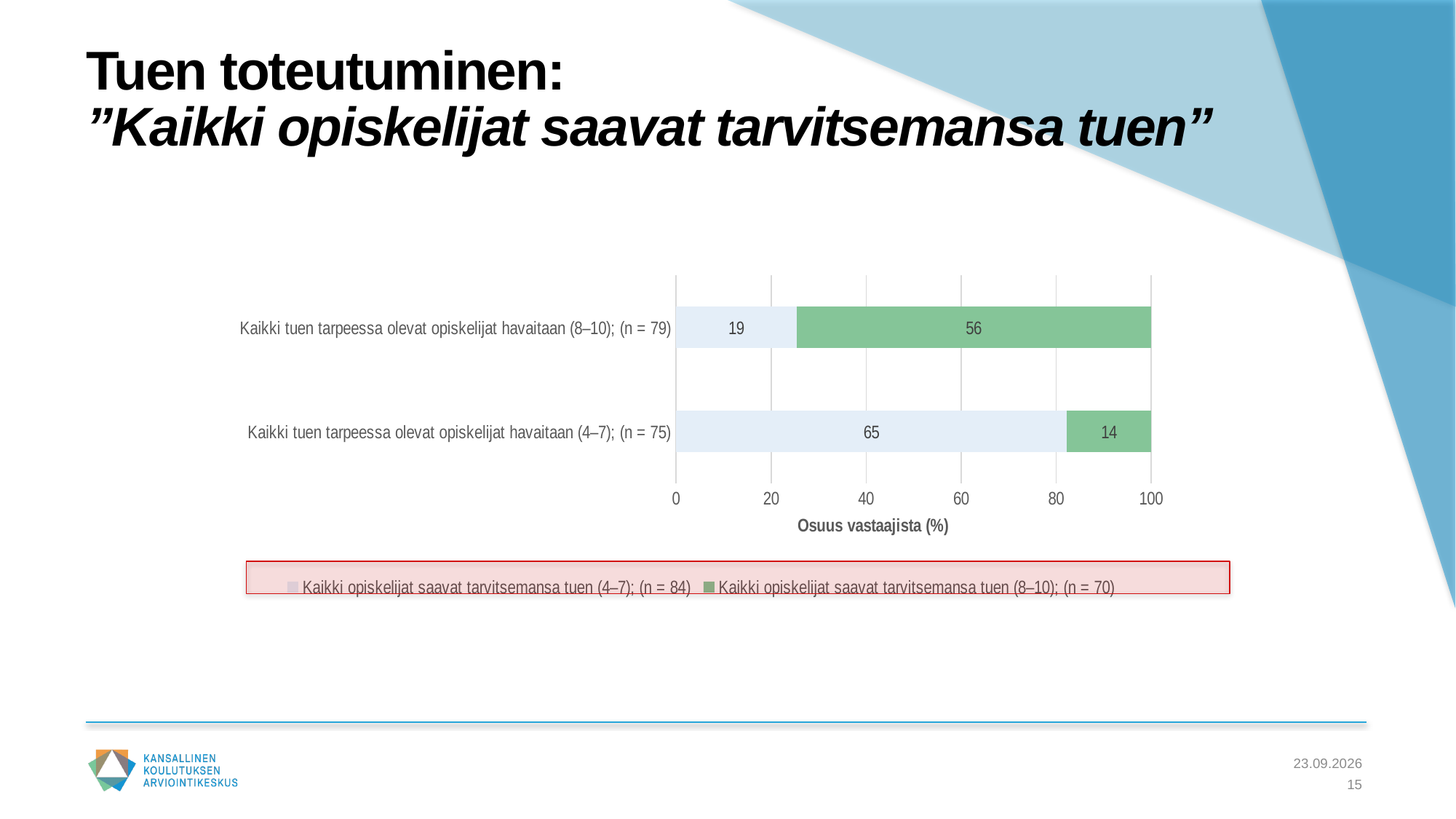
Which category has the higher value for the series "Kaikki opiskelijat saavat tarvitsemansa tuen (8–10); (n = 70)"? Kaikki tuen tarpeessa olevat opiskelijat havaitaan (8–10); (n = 79) What is the title of the horizontal axis of the chart? Osuus vastaajista (%) How many series does the chart's legend list? 2 What is the total of the stacked bar for "Kaikki tuen tarpeessa olevat opiskelijat havaitaan (4–7); (n = 75)"? 100 What kind of chart is shown on the slide? bar chart What is the total of the stacked bar for "Kaikki tuen tarpeessa olevat opiskelijat havaitaan (8–10); (n = 79)"? 100 How many categories are shown on the vertical axis of the chart? 2